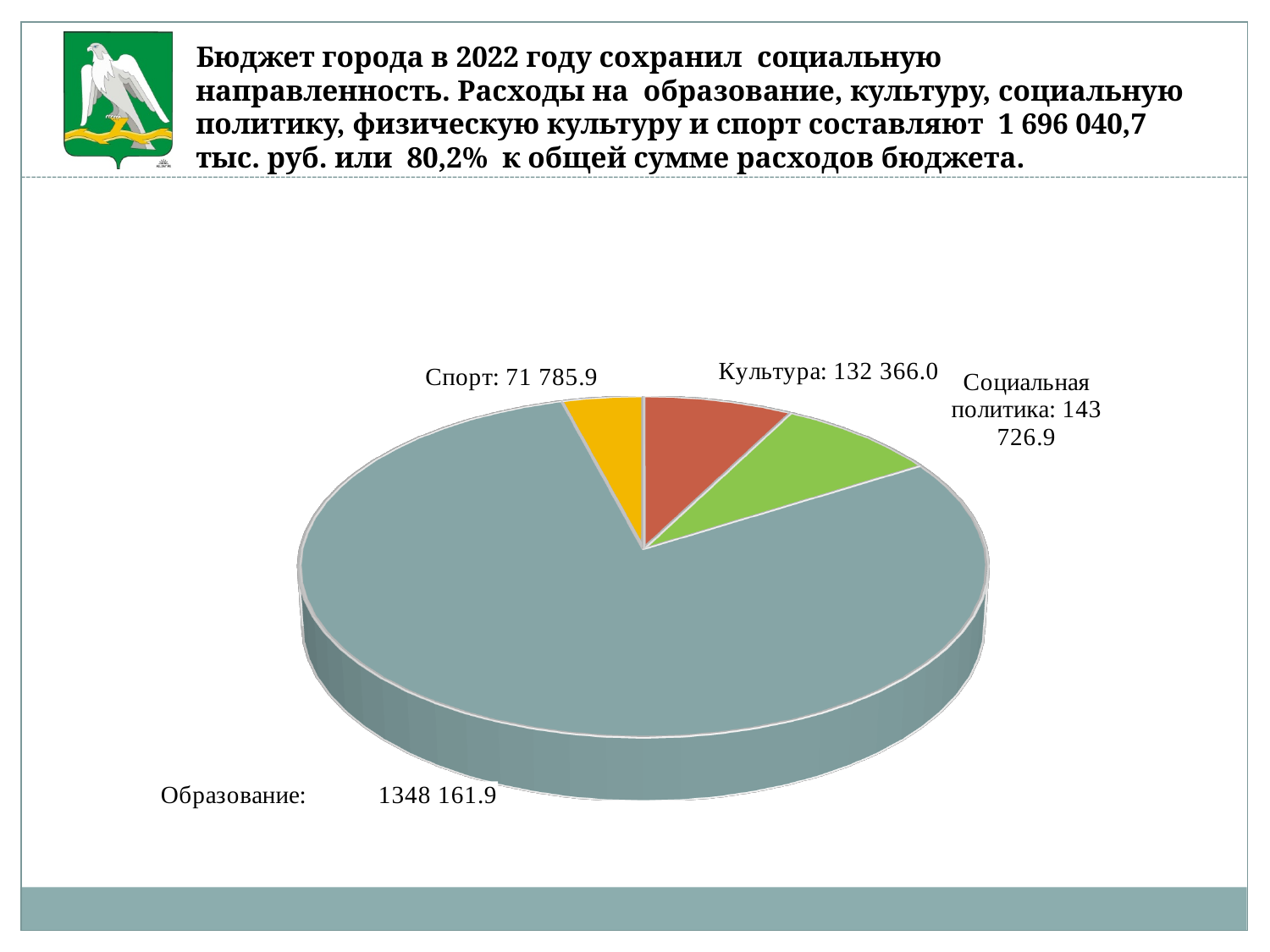
What kind of chart is shown on the slide? Pie chart What is the difference between the values for Социальная политика and Культура? 11 360.9 What is the value shown for Спорт on the pie chart? 71 785.9 What is the difference between the values for Культура and Спорт? 60 580.1 Which category has the largest slice of the pie chart? Образование What is the value shown for Социальная политика on the pie chart? 143 726.9 How many slices does the pie chart have? 4 What colour is the Спорт slice of the pie chart? Yellow Which category has the smallest slice of the pie chart? Спорт What is the value shown for Культура on the pie chart? 132 366.0 Which is larger on the pie chart: Социальная политика or Культура? Социальная политика What is the value shown for Образование on the pie chart? 1348 161.9